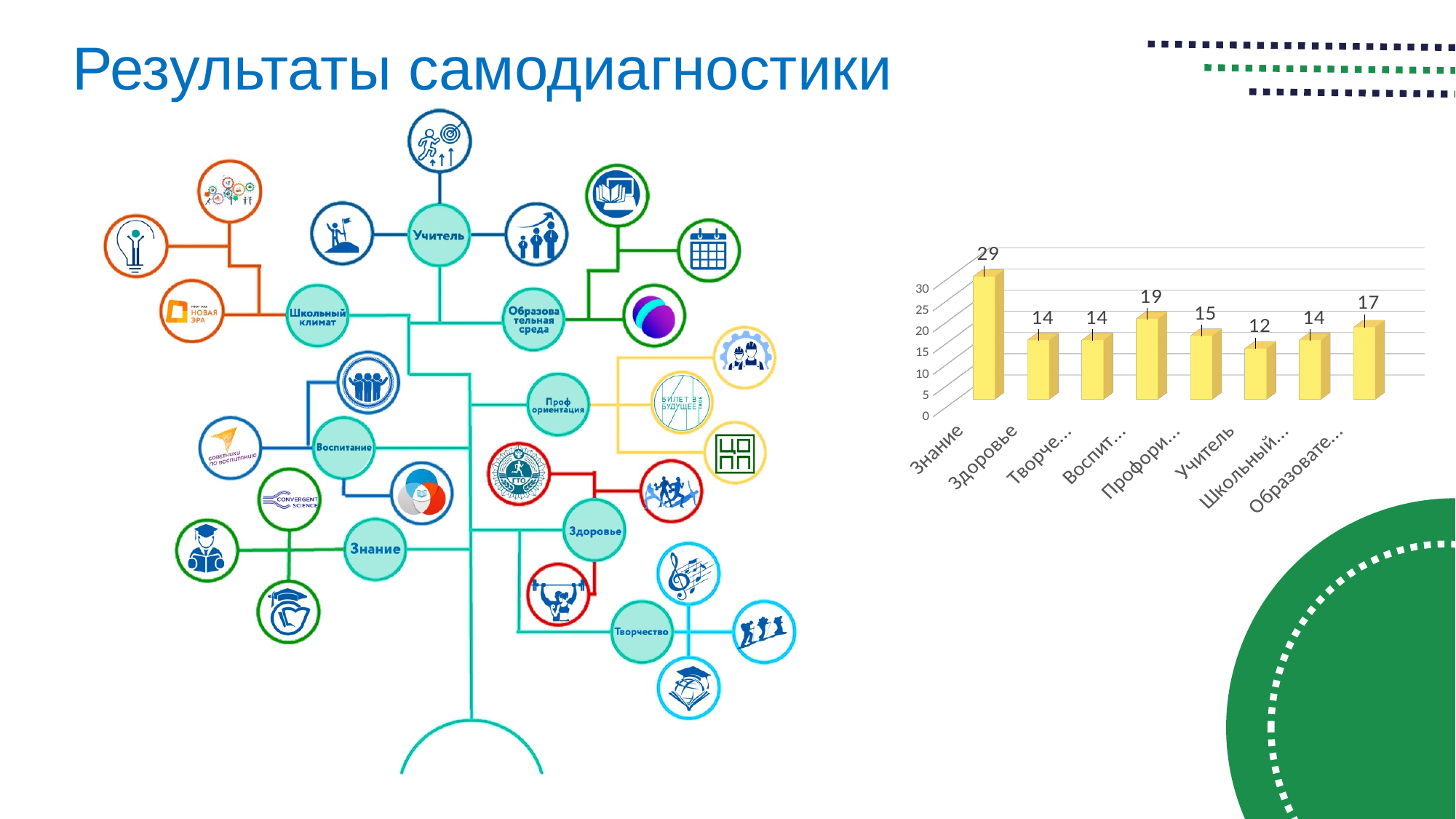
What is the difference between the values for Знание and Учитель? 17 Which is larger, the value for Здоровье or the value for Учитель? Здоровье What is the value for Учитель? 12 What is the value for the category labelled "Воспит…"? 19 What is the value for Знание? 29 Which category has the highest value? Знание What is the value for the category labelled "Образовате…"? 17 Is the value for Знание greater or less than 25? greater How many categories are shown in the chart? 8 What is the value for Здоровье? 14 What kind of chart is shown on the slide? bar chart Which category has the lowest value? Учитель